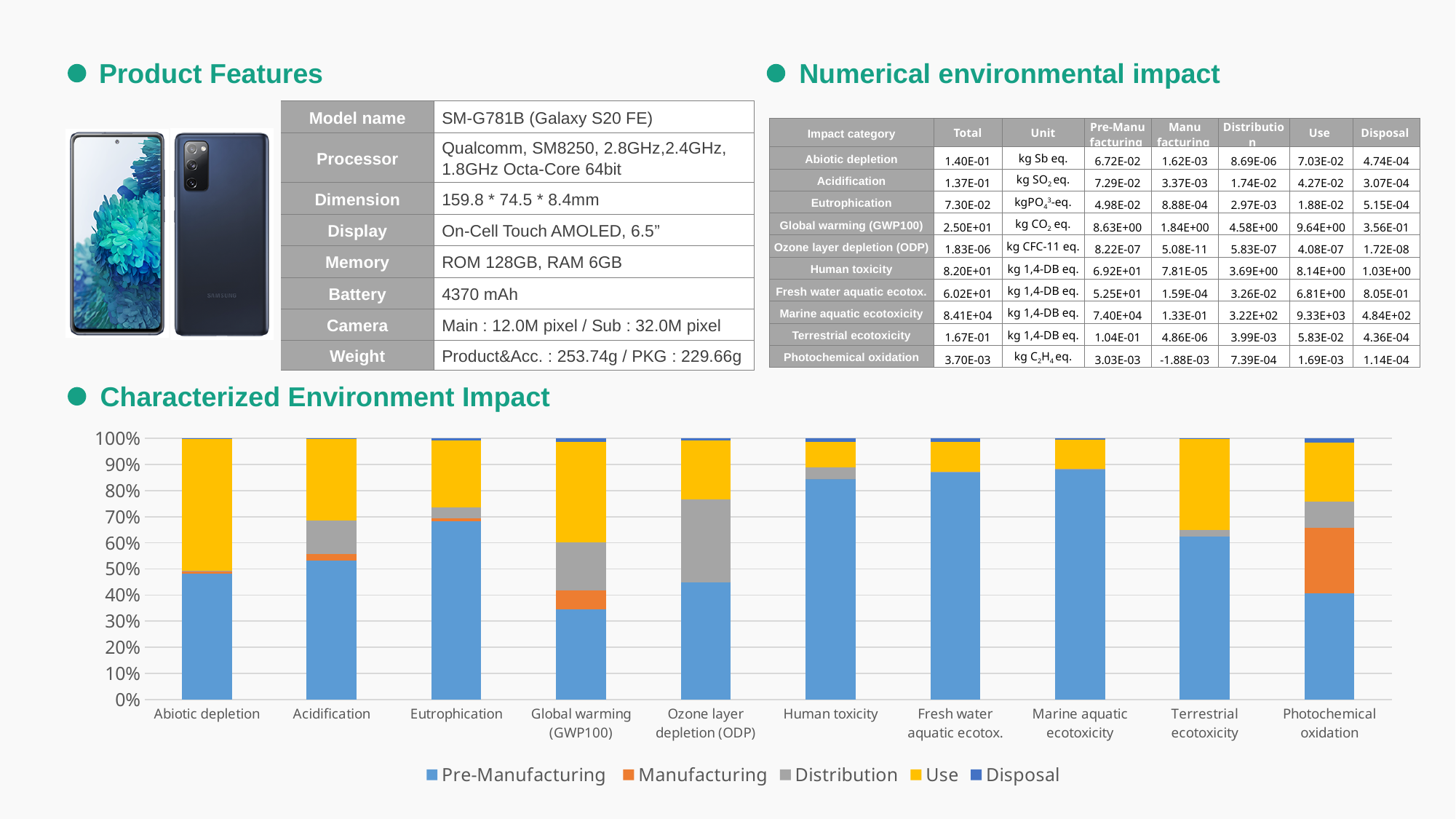
In the Characterized Environment Impact chart, is the Pre-Manufacturing share for Photochemical oxidation greater or less than 50%? less What kind of chart is shown under 'Characterized Environment Impact'? Stacked bar chart In the Characterized Environment Impact chart, is the Pre-Manufacturing share for Terrestrial ecotoxicity greater or less than 50%? greater In the Characterized Environment Impact chart, which category has the smallest Pre-Manufacturing share? Global warming (GWP100) In the Characterized Environment Impact chart, which category has the largest Manufacturing segment? Photochemical oxidation How many series does the legend of the Characterized Environment Impact chart list? 5 In the Characterized Environment Impact chart, which category has the largest Use segment? Abiotic depletion Which series is shown in orange in the Characterized Environment Impact chart? Manufacturing In the Characterized Environment Impact chart, is the Pre-Manufacturing share for Global warming (GWP100) greater or less than 40%? less What is the title of the chart on the slide? Characterized Environment Impact How many impact categories are plotted along the x axis of the Characterized Environment Impact chart? 10